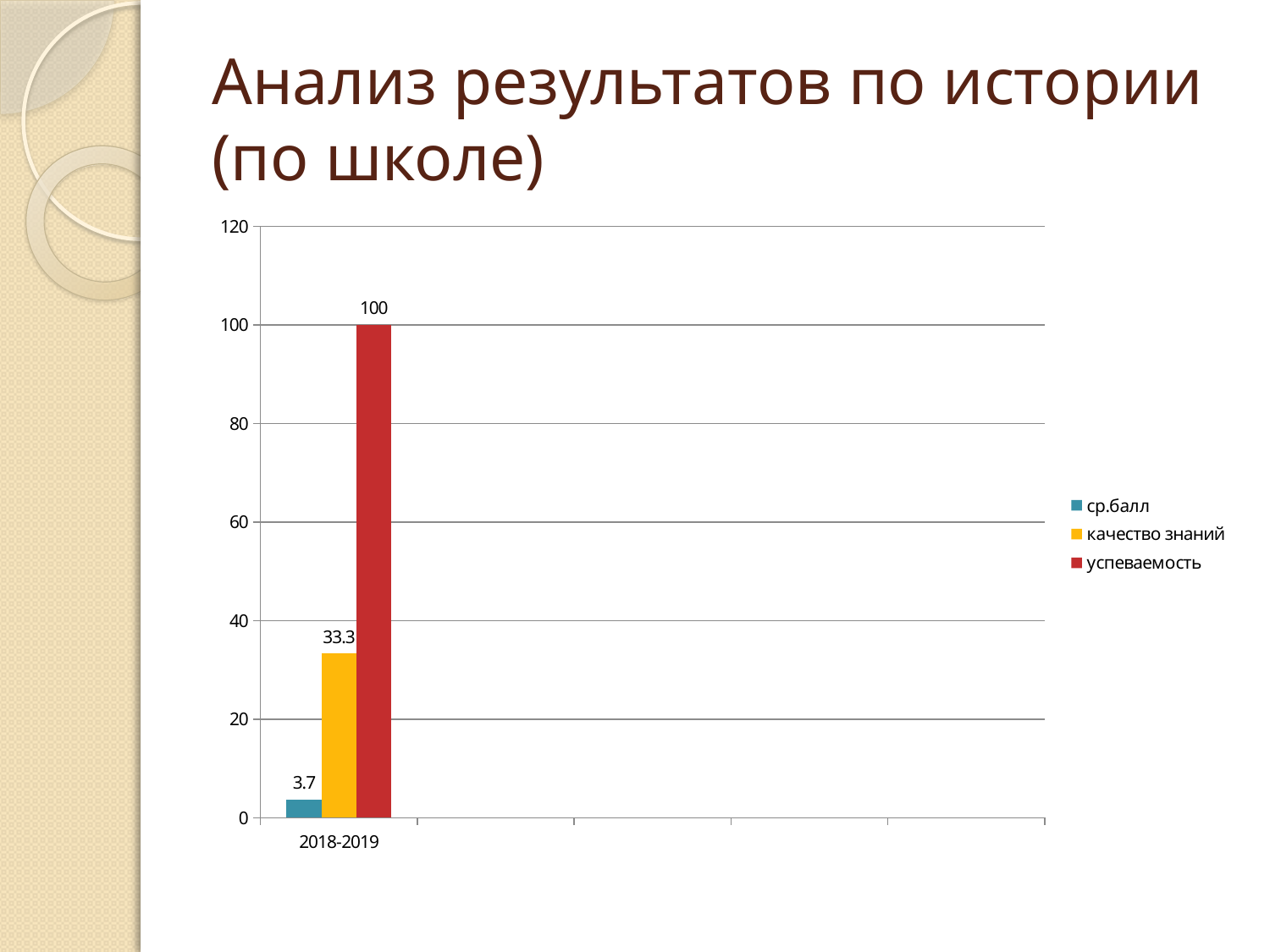
What is the value of ср.балл for 2018-2019? 3.7 Is the value for качество знаний greater or less than 40? less How many series does the legend list? 3 Which is larger for 2018-2019: качество знаний or ср.балл? качество знаний Which series has the lowest value for 2018-2019? ср.балл Which series has the highest value for 2018-2019? успеваемость What is the value of качество знаний for 2018-2019? 33.3 What colour is the bar for успеваемость? red What is the value of успеваемость for 2018-2019? 100 What kind of chart is shown on the slide? bar chart How many categories are shown on the x axis? 1 What is the difference between успеваемость and качество знаний for 2018-2019? 66.7